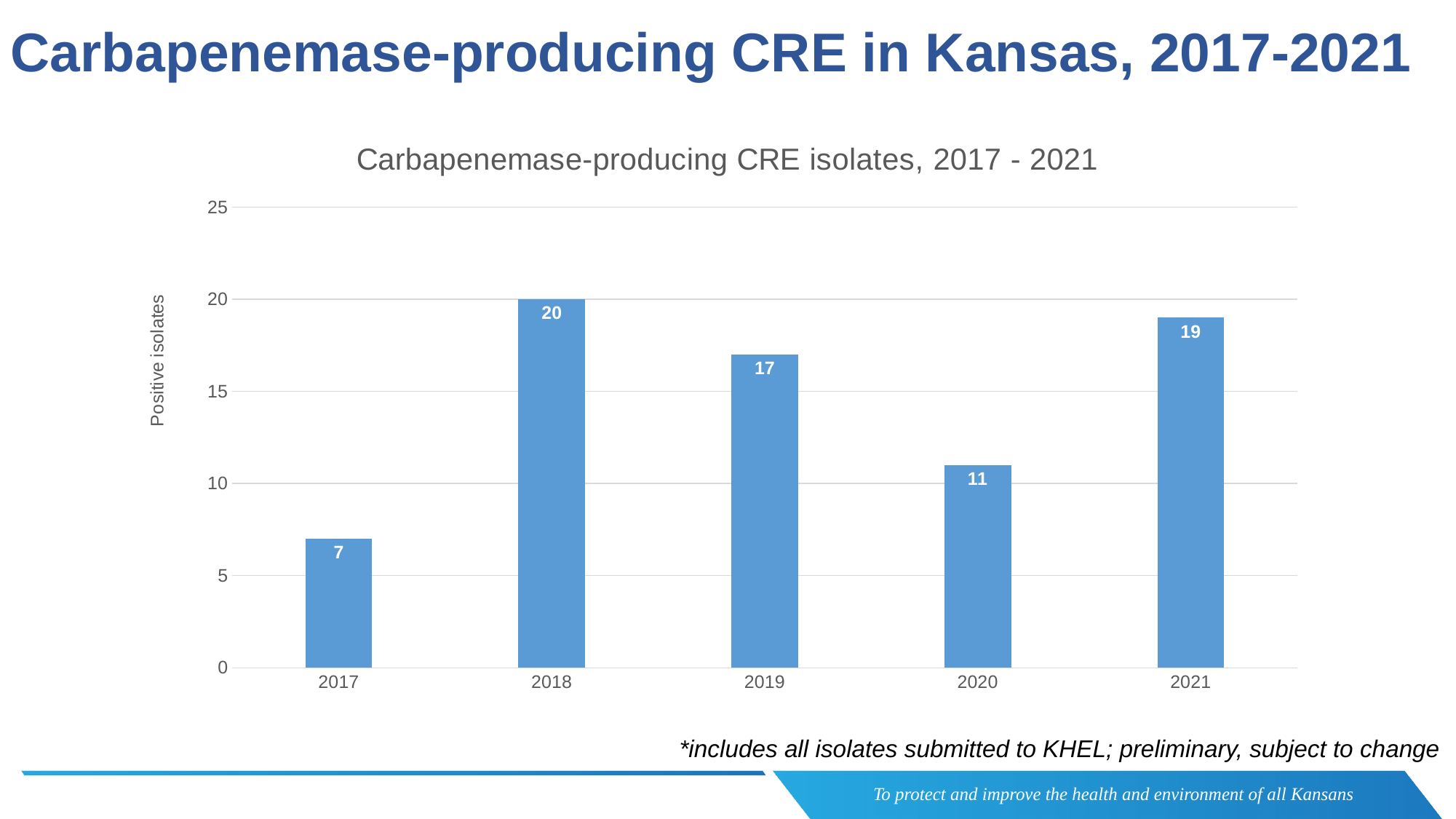
How many positive isolates were there in 2018? 20 What is the difference between the values for 2018 and 2017? 13 What is the difference between the values for 2021 and 2020? 8 Is the value for 2021 greater or less than 15? greater What kind of chart is shown on the slide? bar chart Which year has the lowest number of positive isolates? 2017 What is the value for 2020? 11 What is the title of the chart? Carbapenemase-producing CRE isolates, 2017 - 2021 Did the number of positive isolates rise or fall from 2019 to 2020? fall Which year has the highest number of positive isolates? 2018 Which is larger, the value for 2019 or the value for 2020? 2019 How many years are shown on the x axis? 5